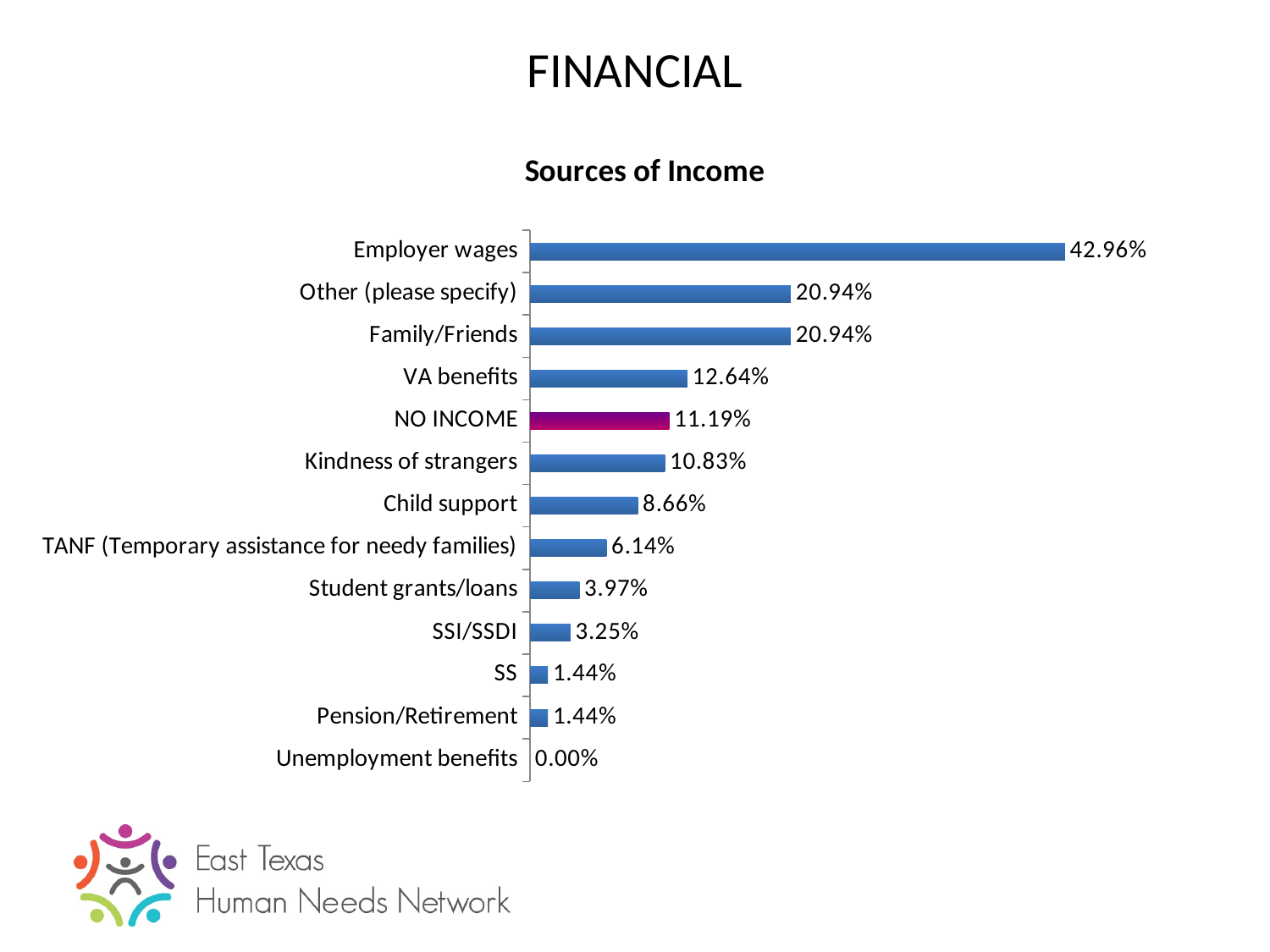
Which is larger, the value for Child support or the value for Student grants/loans? Child support What is the value for NO INCOME? 11.19% What kind of chart is shown on the slide? Bar chart What is the value for VA benefits? 12.64% What is the value for TANF (Temporary assistance for needy families)? 6.14% How many categories are shown in the chart? 13 What is the difference between the values for Employer wages and Family/Friends? 22.02% What is the difference between the values for NO INCOME and Kindness of strangers? 0.36% Which source of income has the highest value? Employer wages Which source of income has the lowest value? Unemployment benefits What is the value for Employer wages? 42.96% Which bar is shown in a different colour from the others? NO INCOME